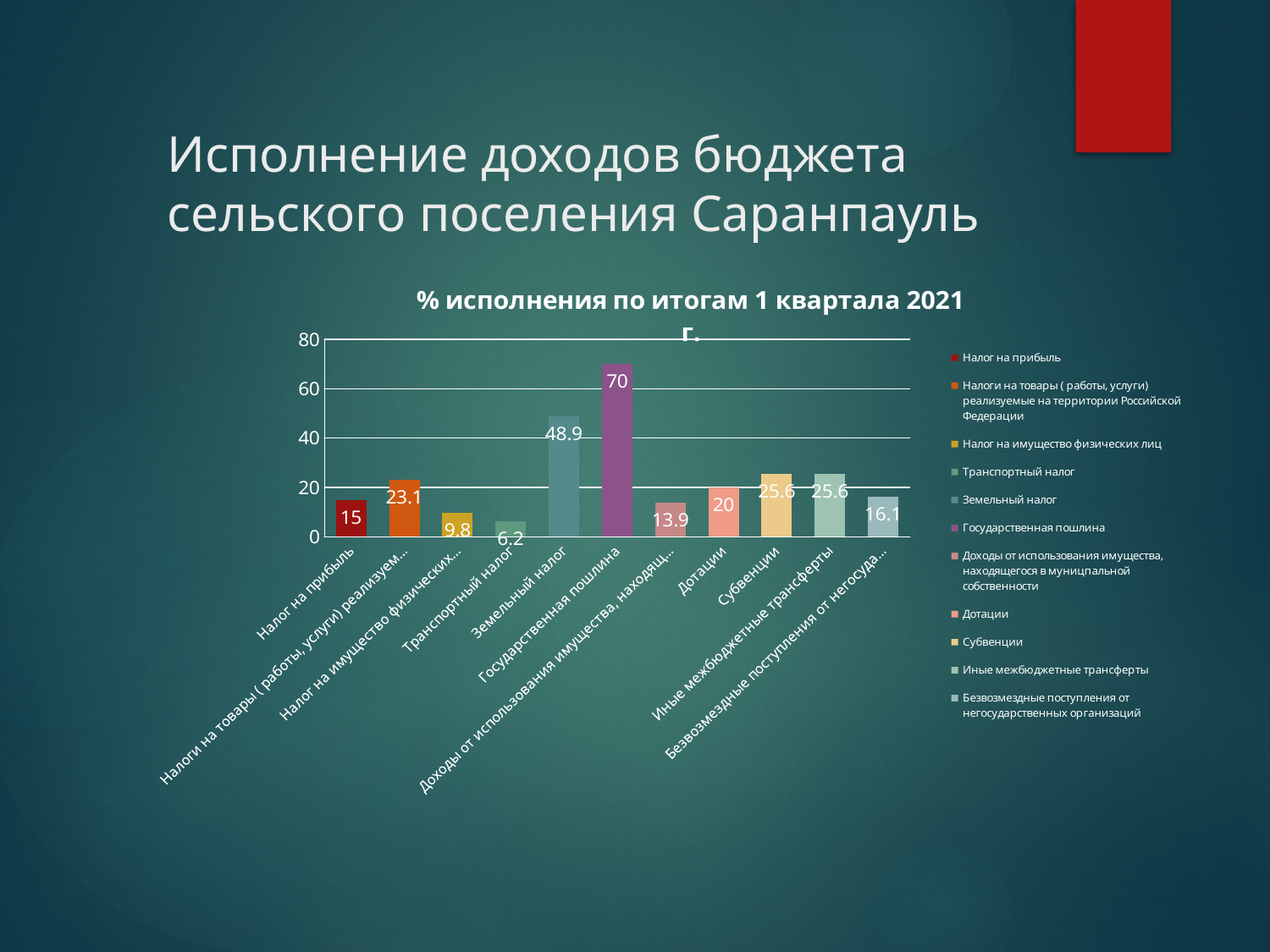
Which is larger, the value for Налог на прибыль or the value for Дотации? Дотации Which category has the highest value? Государственная пошлина Which category has the lowest value? Транспортный налог How many categories are plotted in the chart? 11 What is the value for Государственная пошлина? 70 What is the title of the chart? % исполнения по итогам 1 квартала 2021 г. What is the value for Земельный налог? 48.9 Is the value for Земельный налог greater or less than 40? greater What is the difference between the values for Государственная пошлина and Земельный налог? 21.1 What is the value for Налог на прибыль? 15 What kind of chart is shown on the slide? bar chart What is the value for Дотации? 20